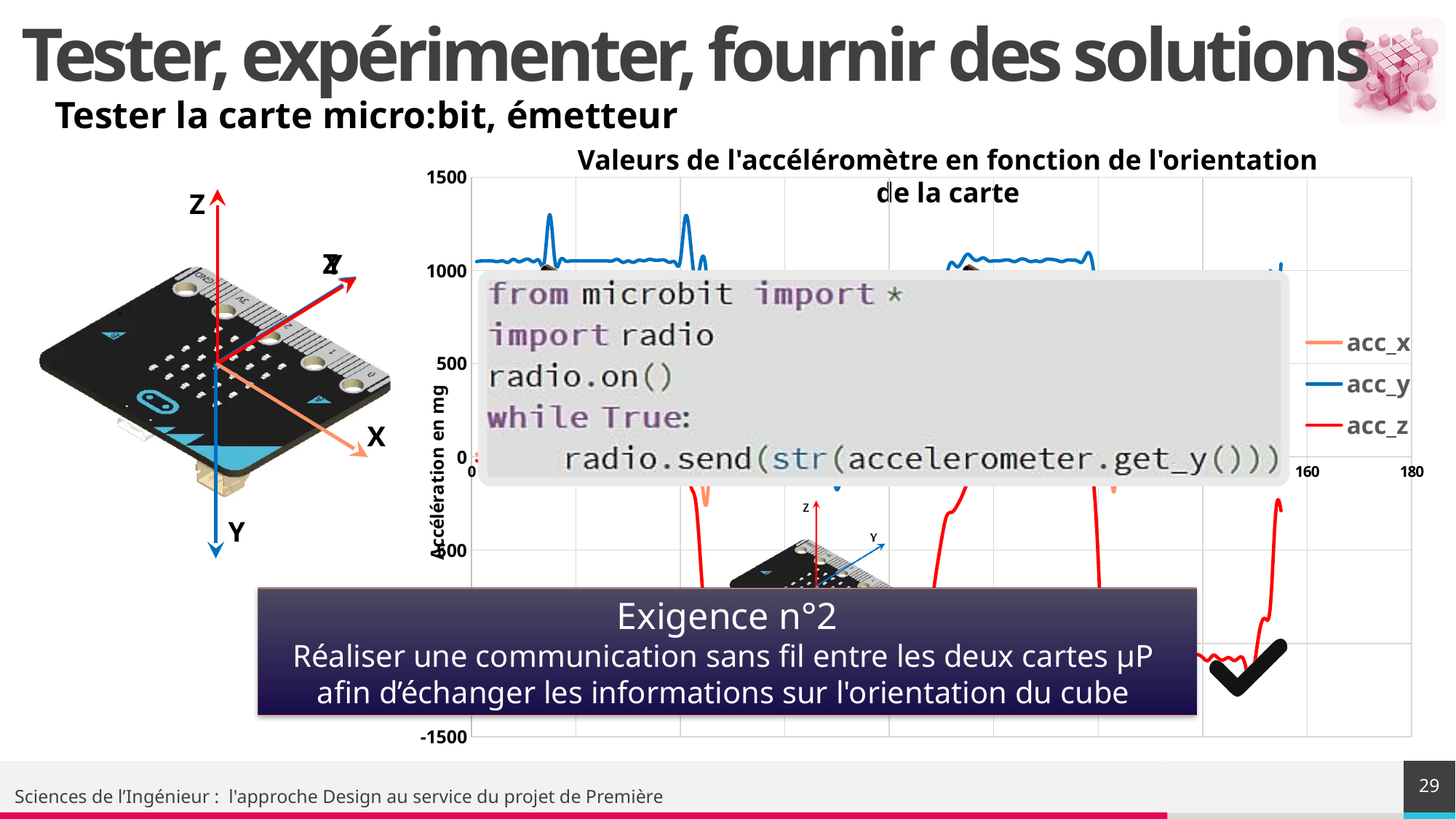
What are the names of the three series in the chart legend? acc_x, acc_y, acc_z Is the acc_y value at the start of the chart (near x = 0) greater or less than 1500? less How many series does the chart legend list? 3 Is the acc_y value at the start of the chart (near x = 0) greater or less than 1000? greater What is the title of the chart? Valeurs de l'accéléromètre en fonction de l'orientation de la carte Is the acc_y value at the start of the chart (near x = 0) greater or less than 500? greater Which series is plotted in red? acc_z What kind of chart is shown on the slide? line chart